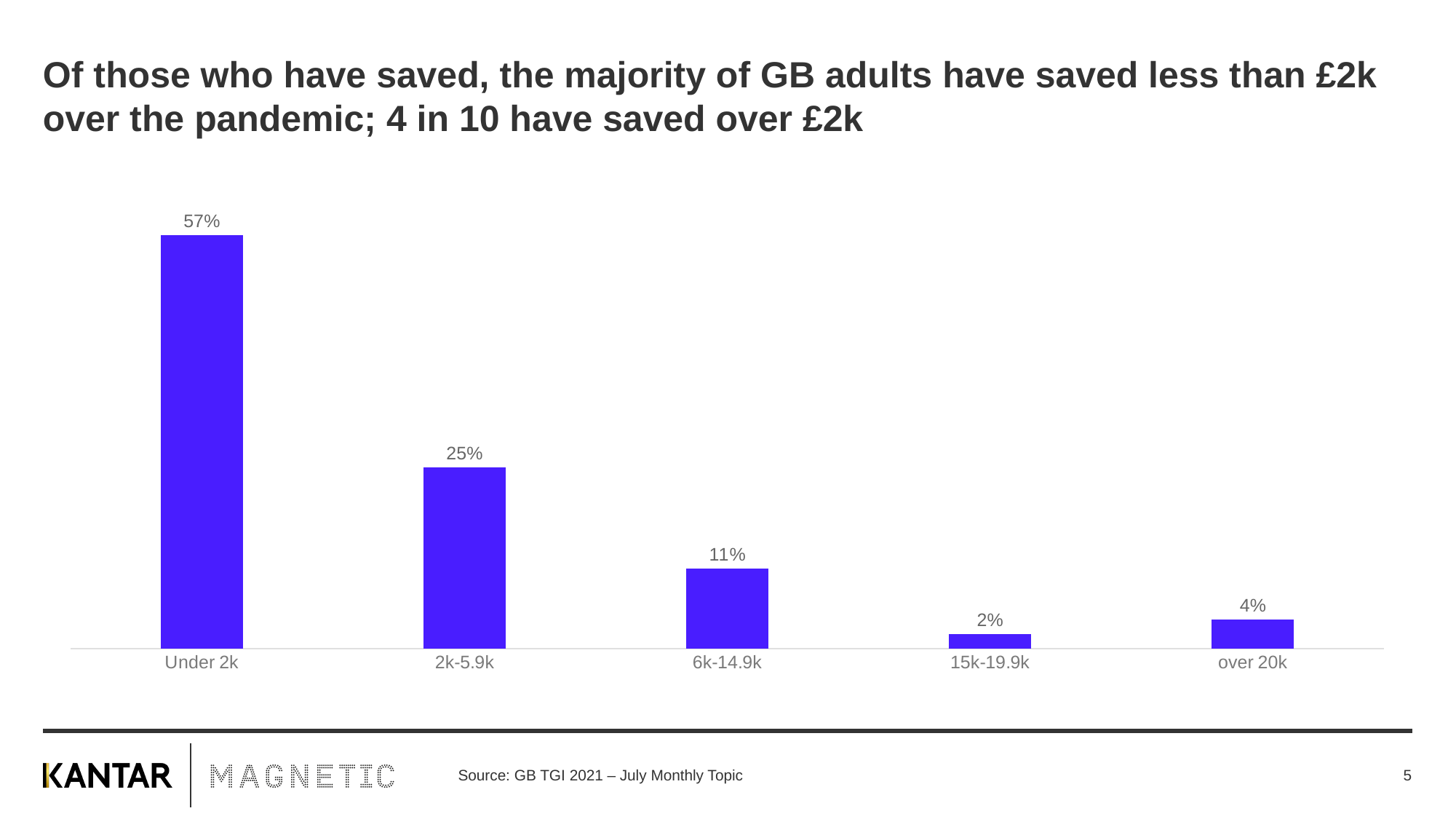
Which category has the lowest value? 15k-19.9k How many categories are shown on the chart? 5 What is the value for over 20k? 4% What is the difference between the values for Under 2k and 2k-5.9k? 32% Which is larger, the value for over 20k or the value for 15k-19.9k? over 20k What is the value for 6k-14.9k? 11% What kind of chart is shown on the slide? Bar chart Which category has the highest value? Under 2k What is the value for Under 2k? 57% What is the value for 2k-5.9k? 25% What is the source cited at the bottom of the slide? GB TGI 2021 – July Monthly Topic What is the value for 15k-19.9k? 2%